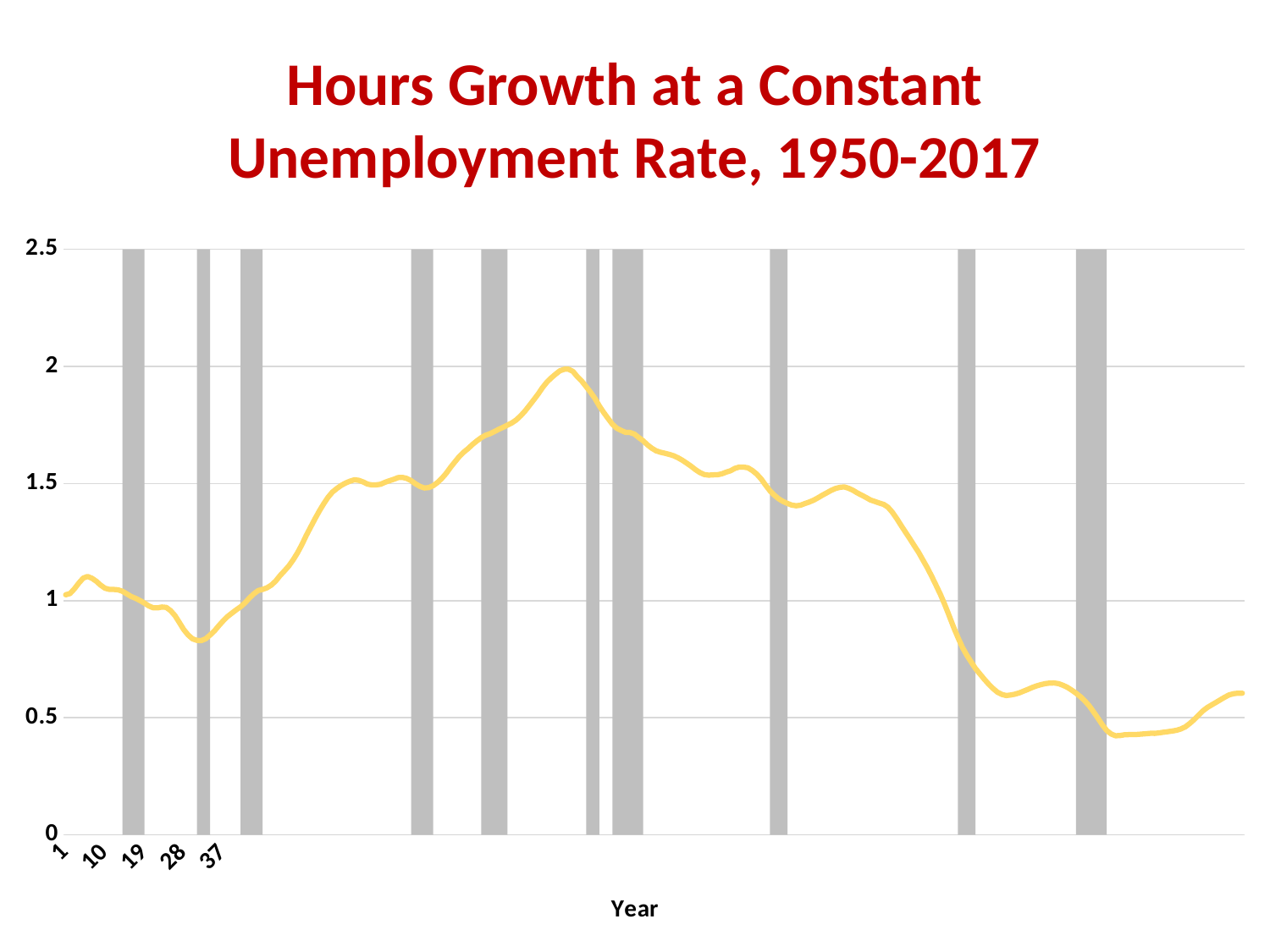
Is the lowest value of the line greater or less than 0.5? less What kind of chart is shown on the slide? line chart What is the title of the chart? Hours Growth at a Constant Unemployment Rate, 1950-2017 Does the line rise or fall from its peak to the right end of the chart? fall Is the value at the right end of the line greater or less than 1? less How many tick values are labelled on the y axis? 6 Comparing the start of the line with its end, which is higher? the start Does the line rise or fall from x-axis label 37 to its peak? rise What is the label on the x axis of the chart? Year Is the peak value of the line greater or less than 1.5? greater What is the highest value shown on the y axis? 2.5